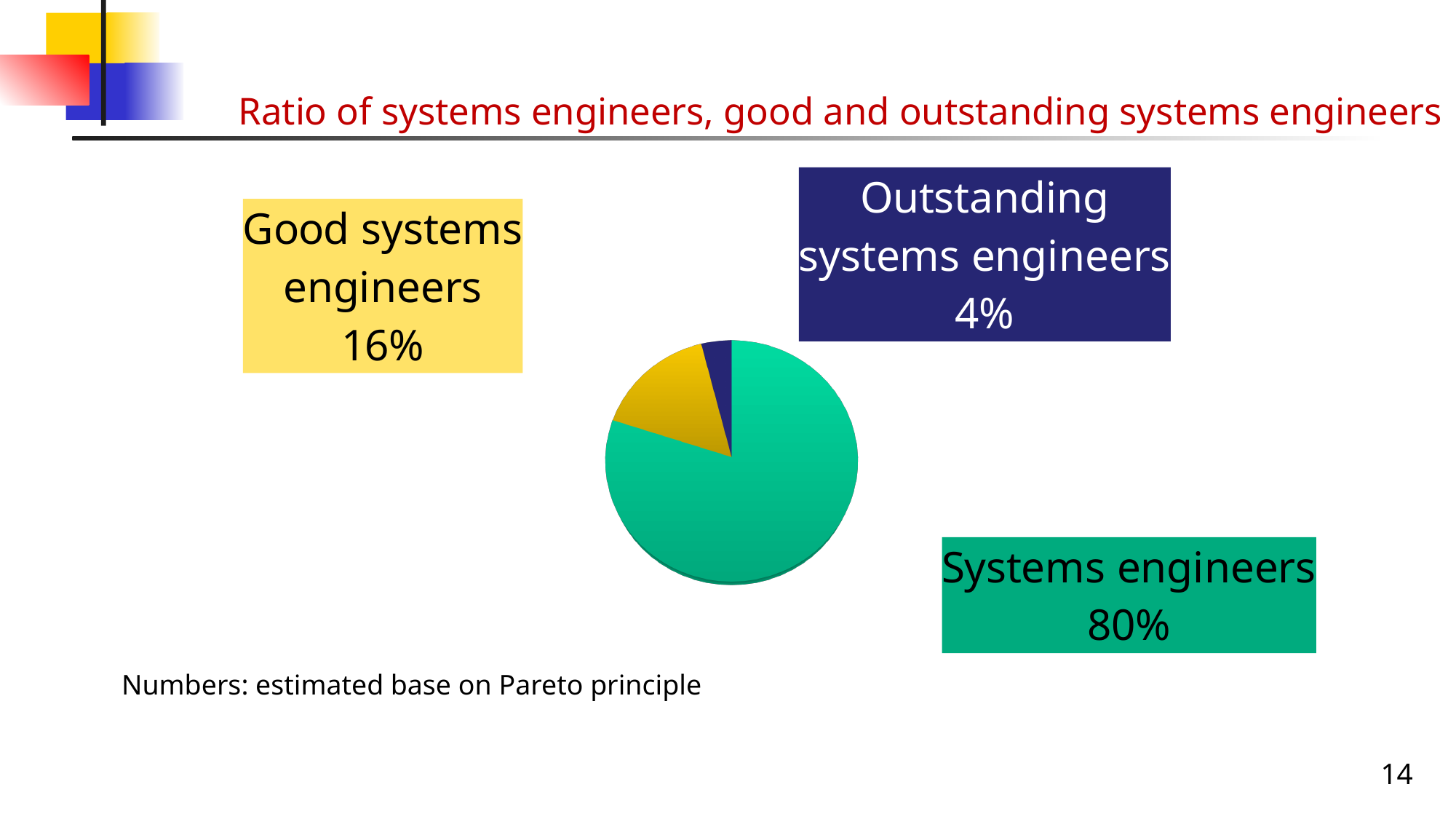
Which category has the largest slice of the pie? Systems engineers What is the difference between the Good systems engineers share and the Outstanding systems engineers share? 12% What kind of chart is shown on the slide? Pie chart What is the title of the slide containing the pie chart? Ratio of systems engineers, good and outstanding systems engineers Which is larger, the Good systems engineers slice or the Outstanding systems engineers slice? Good systems engineers Which category has the smallest slice of the pie? Outstanding systems engineers What share of the pie is labelled Outstanding systems engineers? 4% What share of the pie is labelled Good systems engineers? 16% What is the difference between the Systems engineers share and the Good systems engineers share? 64% What colour is the Systems engineers slice of the pie? Green What share of the pie is labelled Systems engineers? 80% How many slices does the pie chart have? 3